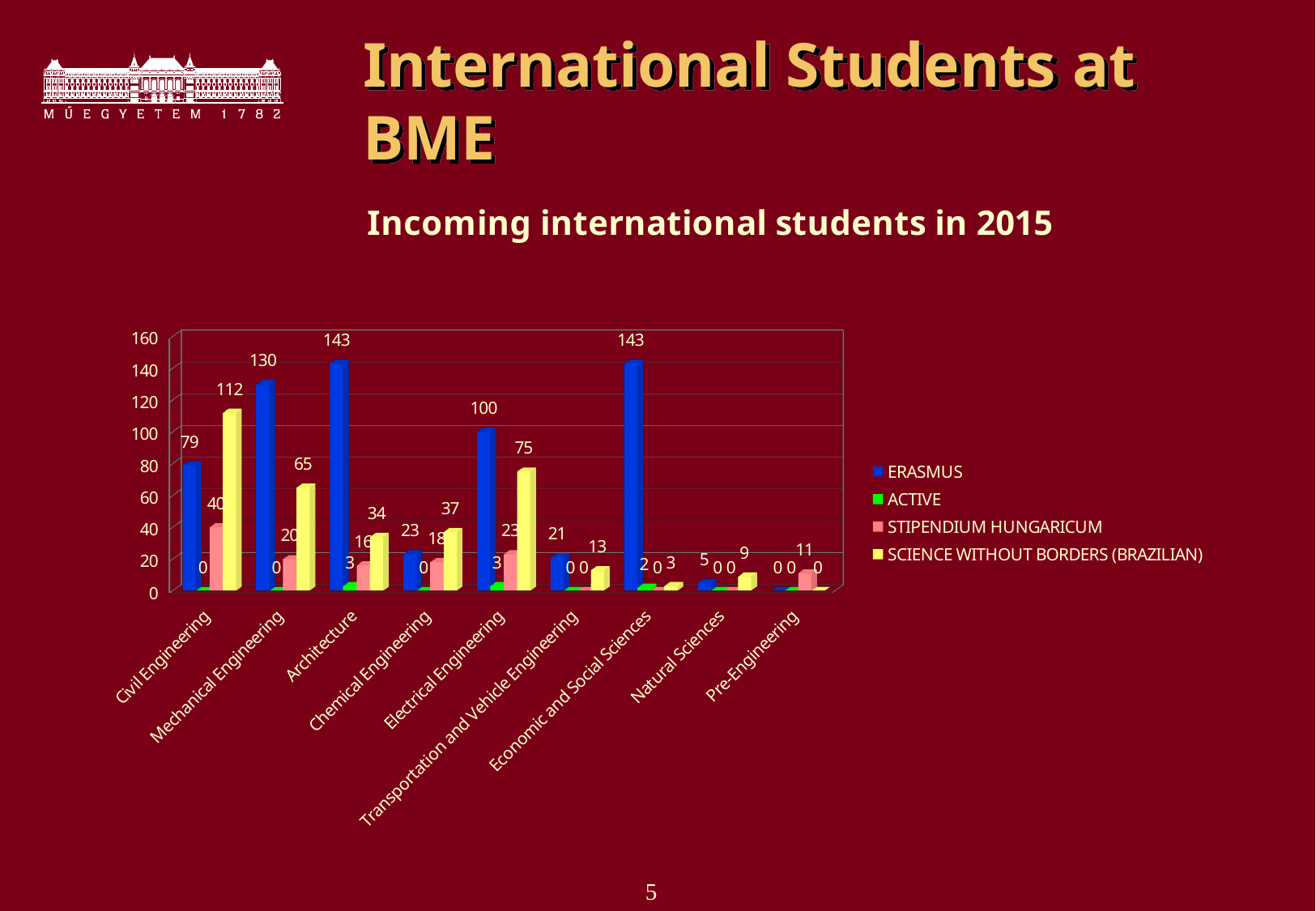
What is the difference between the ERASMUS values for Architecture and Electrical Engineering? 43 How many categories (faculties) are shown on the x axis? 9 How many series does the legend list? 4 What is the title of the chart? Incoming international students in 2015 Which category has the highest STIPENDIUM HUNGARICUM value? Civil Engineering Which is larger for Chemical Engineering: the ERASMUS value or the SCIENCE WITHOUT BORDERS (BRAZILIAN) value? SCIENCE WITHOUT BORDERS (BRAZILIAN) Which category has the highest SCIENCE WITHOUT BORDERS (BRAZILIAN) value? Civil Engineering What is the ERASMUS value for Mechanical Engineering? 130 What type of chart is shown on the slide? bar chart What is the STIPENDIUM HUNGARICUM value for Pre-Engineering? 11 What is the ACTIVE value for Economic and Social Sciences? 2 What is the SCIENCE WITHOUT BORDERS (BRAZILIAN) value for Civil Engineering? 112